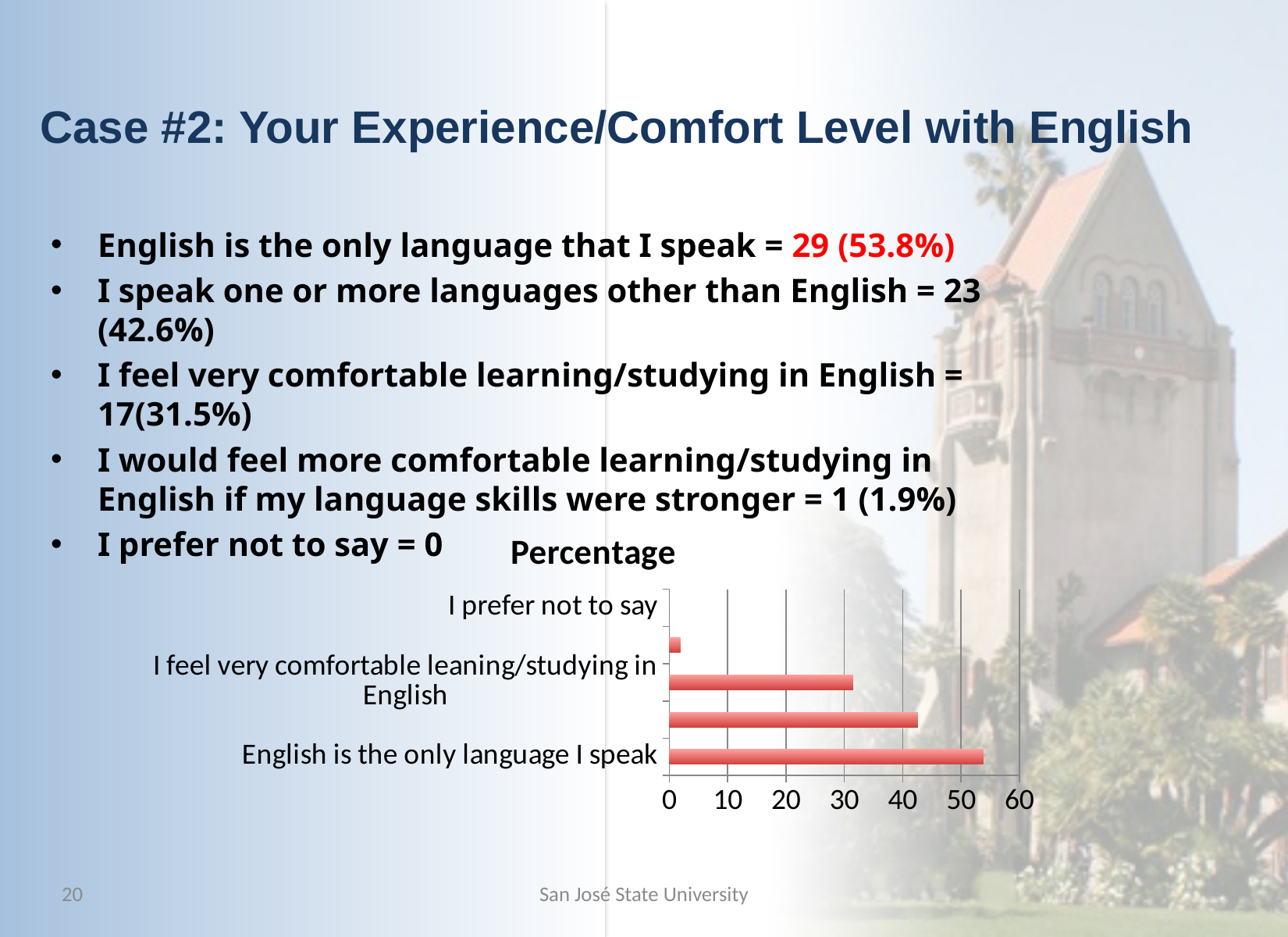
Which labeled category has the smallest value in the chart? I prefer not to say What is the highest value shown on the horizontal axis of the chart? 60 Is the value for "I feel very comfortable leaning/studying in English" greater or less than 20? greater Which is larger: the value for "English is the only language I speak" or the value for "I feel very comfortable leaning/studying in English"? English is the only language I speak How many bars are visible in the chart? 4 What kind of chart is shown on the slide? bar chart Is the value for "English is the only language I speak" greater or less than 50? greater Is the value for "I feel very comfortable leaning/studying in English" greater or less than 40? less What is the title of the chart? Percentage Which category has the longest bar in the chart? English is the only language I speak